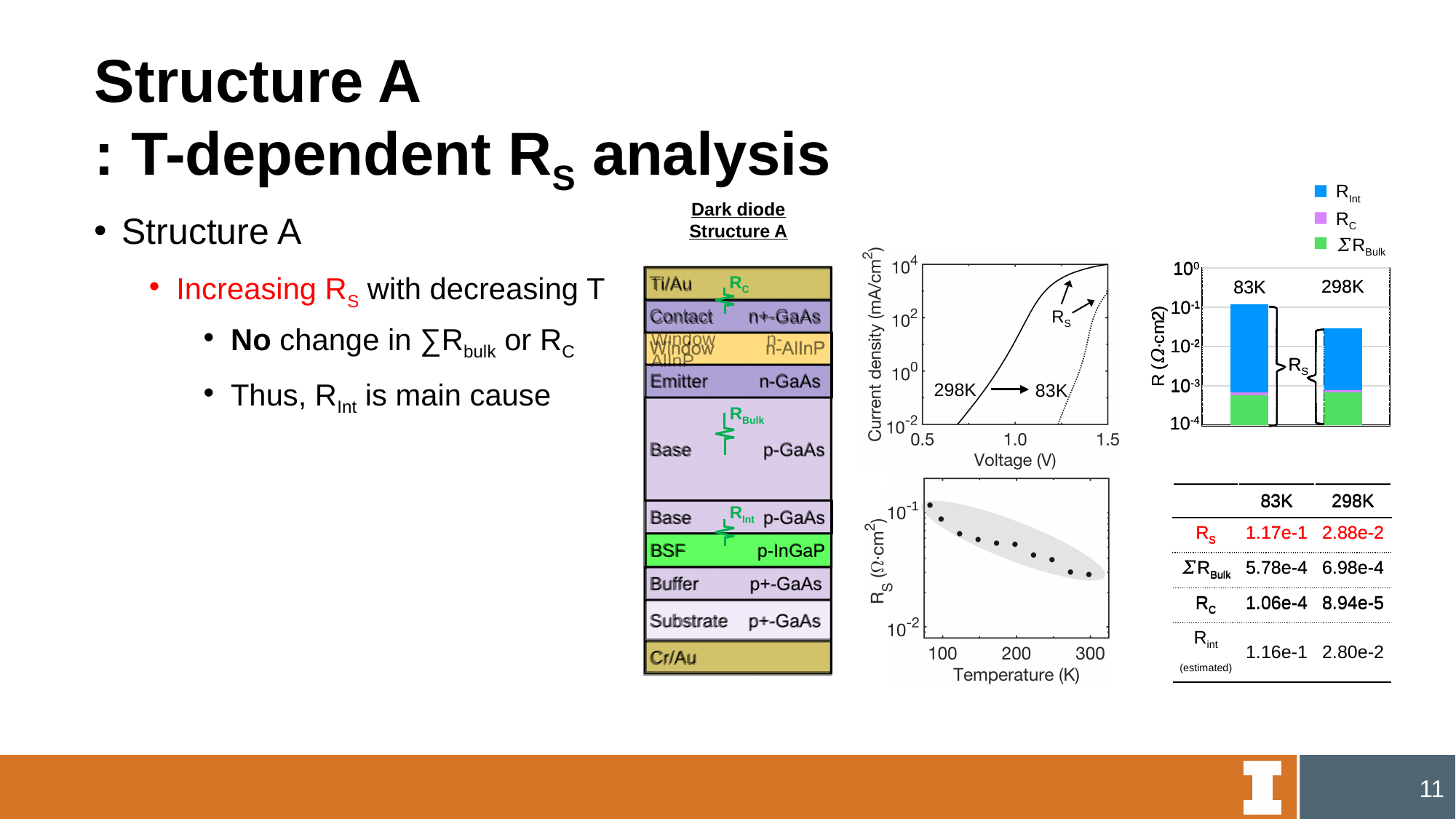
In the stacked bar chart on the right, is the top of the 83K bar greater or less than 10^-2? greater In the stacked bar chart on the right, which category has the taller total bar, 83K or 298K? 83K In the stacked bar chart on the right, which series makes up the largest part of the 83K bar? R_Int How many categories are shown on the x axis of the stacked bar chart on the right? 2 In the R_S versus Temperature chart, does R_S rise or fall as temperature increases? Fall In the current density versus voltage chart, which curve lies further to the right, 298K or 83K? 83K What kind of chart is the R_S versus Temperature chart in the lower middle of the slide? Scatter chart How many series does the legend of the stacked bar chart on the right list? 3 What is the x-axis label of the current density chart in the upper middle of the slide? Voltage (V) In the stacked bar chart on the right, is the top of the 298K bar greater or less than 10^-1? less In the stacked bar chart on the right, which colour represents R_Int? Blue What kind of chart is the chart on the right with the 83K and 298K bars? Stacked bar chart